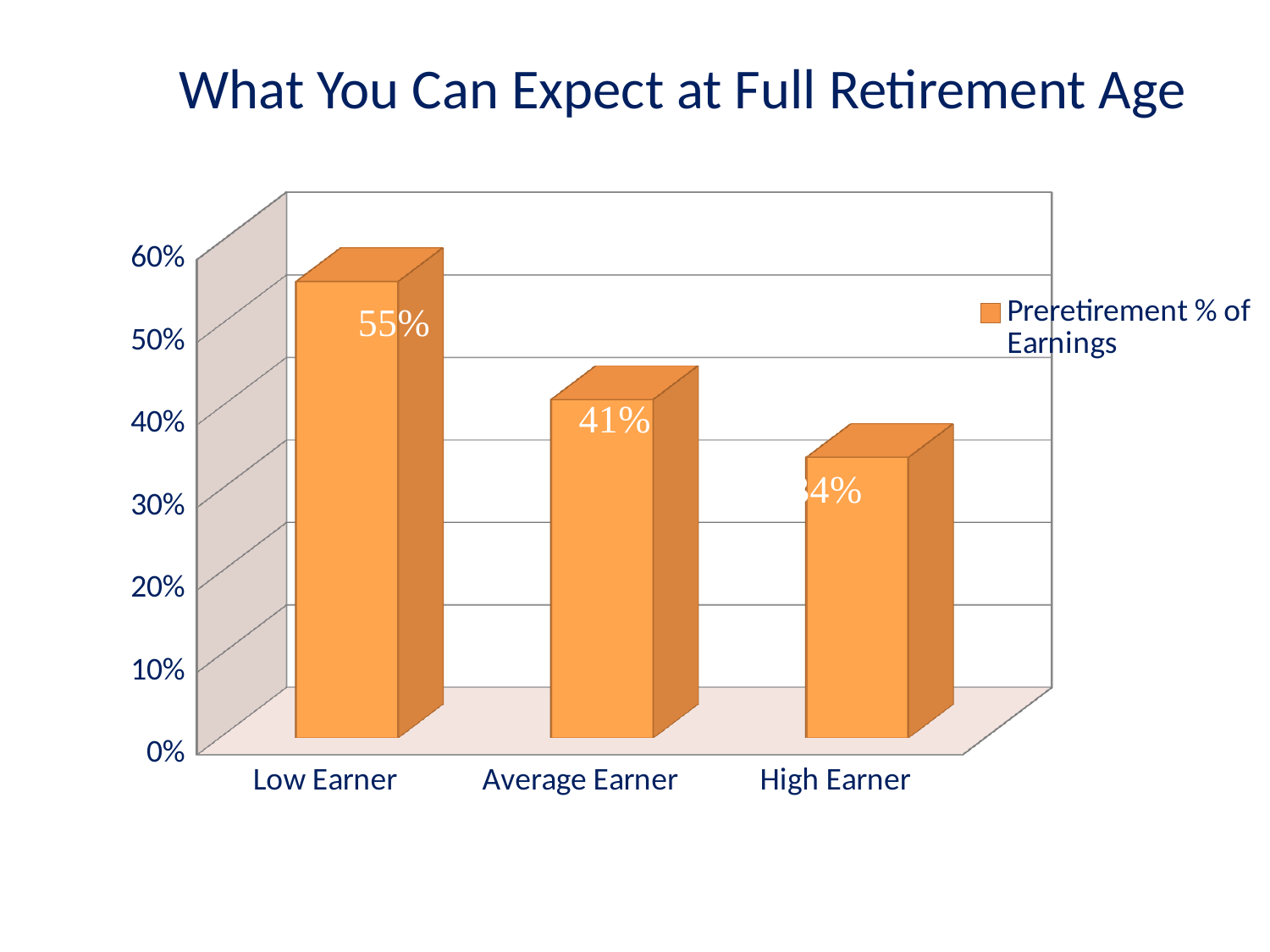
What is the difference between the values for Low Earner and Average Earner? 14% How many categories are shown on the x axis? 3 Which category has the highest value? Low Earner Is the value for Low Earner greater or less than 50%? greater Do the values rise or fall from Low Earner to High Earner? fall What is the value for Average Earner? 41% Is the value for High Earner greater or less than 40%? less Which is larger, the value for Average Earner or the value for High Earner? Average Earner What kind of chart is shown on the slide? bar chart Which category has the lowest value? High Earner How many series does the legend list? 1 What is the value for Low Earner? 55%